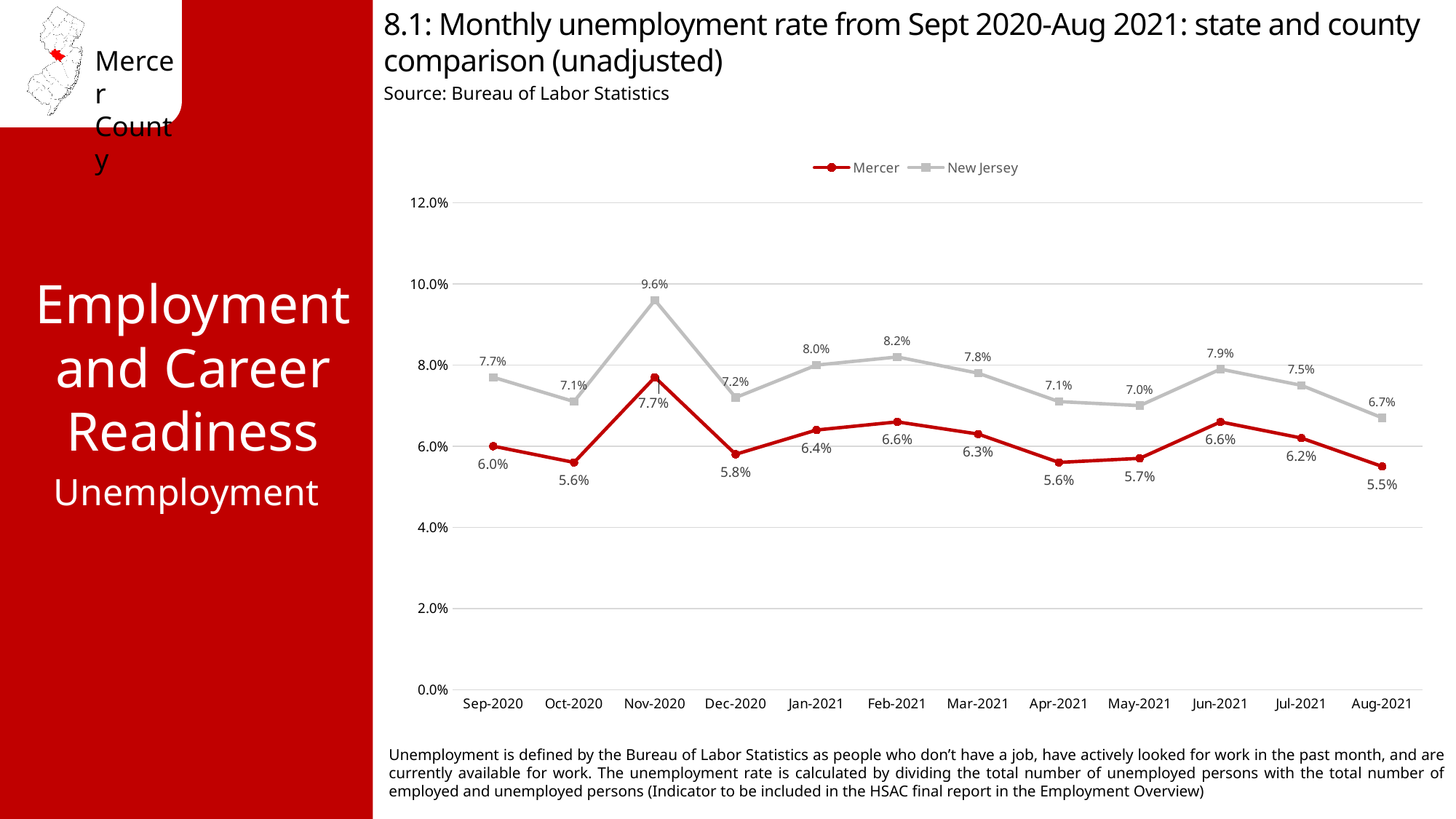
What was the Mercer unemployment rate in Aug-2021? 5.5% In which month did Mercer have its lowest unemployment rate? Aug-2021 What was the New Jersey unemployment rate in Feb-2021? 8.2% How many series does the legend list? 2 What is the difference between the New Jersey and Mercer unemployment rates in Nov-2020? 1.9% Which was higher in Jun-2021, the Mercer rate or the New Jersey rate? New Jersey In which month did New Jersey have its highest unemployment rate? Nov-2020 What is the difference between the New Jersey and Mercer unemployment rates in Jan-2021? 1.6% What was the Mercer unemployment rate in Nov-2020? 7.7% What kind of chart is shown on the slide? Line chart How many months are shown on the x axis? 12 Did the Mercer unemployment rate rise or fall from Jun-2021 to Aug-2021? Fall